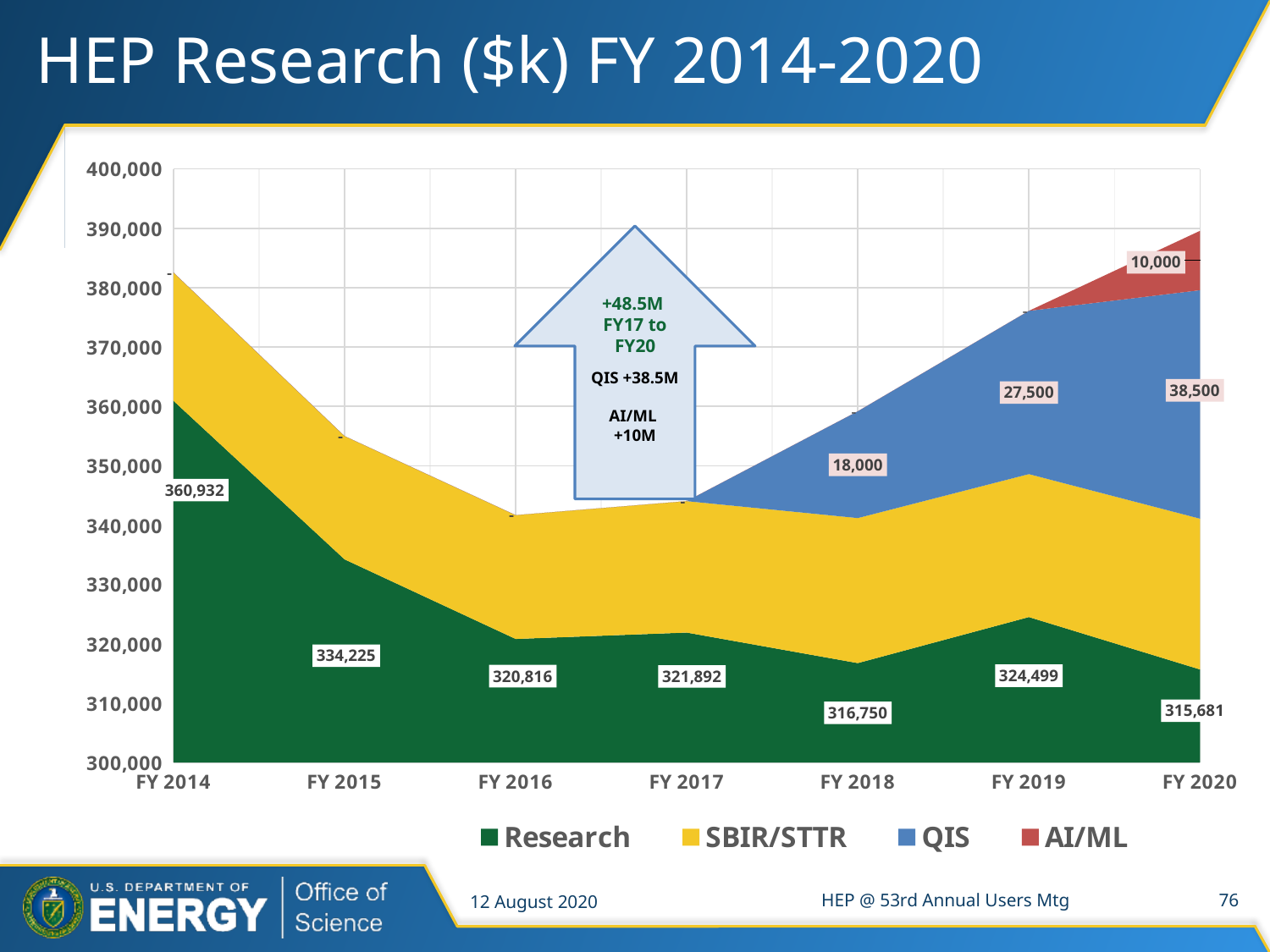
In which fiscal year is the Research value highest? FY 2014 What is the difference between the QIS values for FY 2020 and FY 2018? 20,500 Which is larger, the Research value for FY 2019 or for FY 2017? FY 2019 How many fiscal years are shown on the x axis? 7 Does the Research value rise or fall from FY 2014 to FY 2016? Fall In which fiscal year is the Research value lowest? FY 2020 How many series does the legend list? 4 What kind of chart is shown on the slide? Stacked area chart What is the QIS value for FY 2019? 27,500 What is the Research value for FY 2018? 316,750 What is the AI/ML value for FY 2020? 10,000 What is the Research value for FY 2014? 360,932